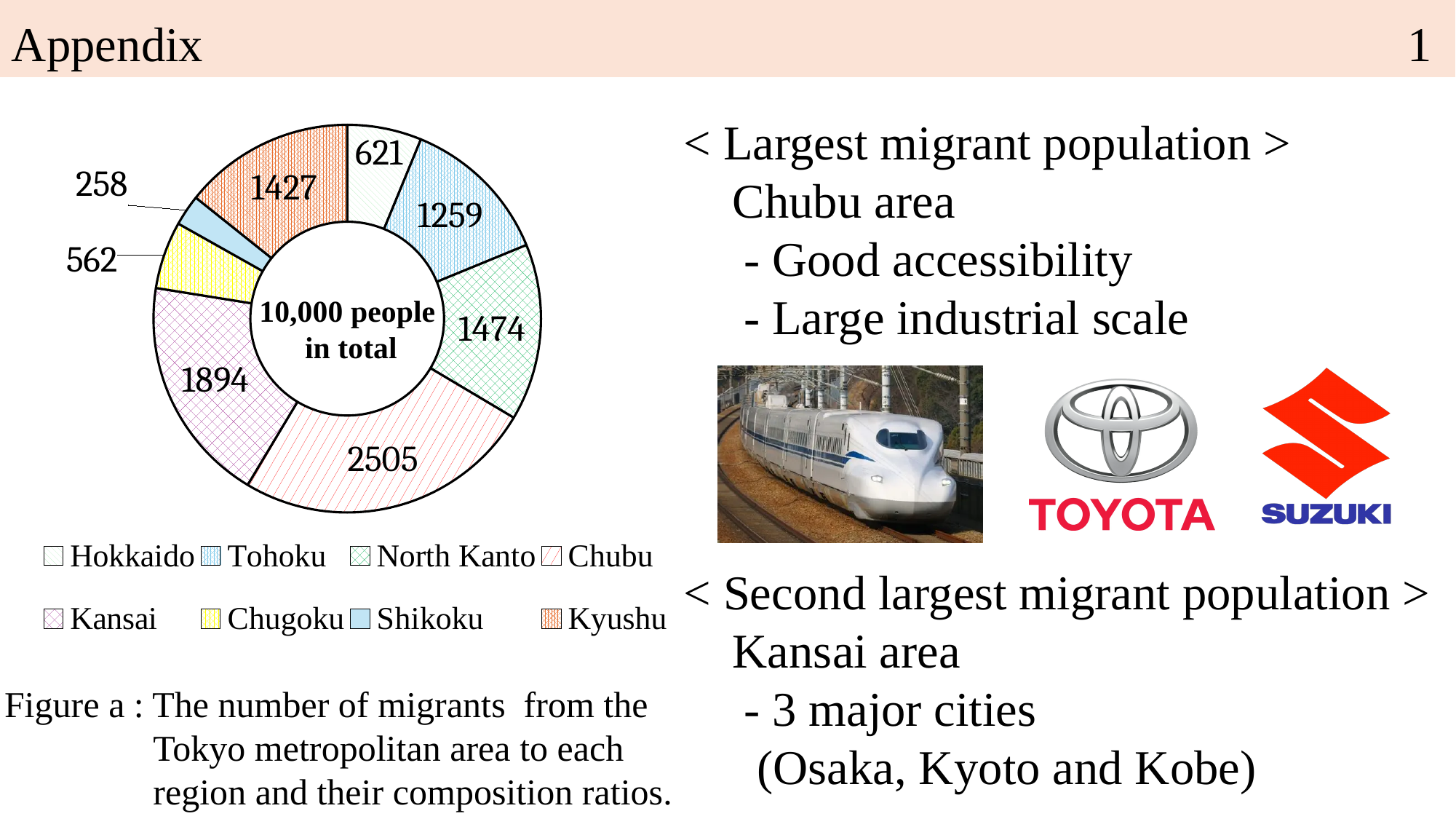
What share of the total does Chubu account for? 25.05% Which region has the smallest slice in the chart? Shikoku Which is larger, the value for North Kanto or the value for Kyushu? North Kanto Which region has the largest slice in the chart? Chubu What value does the chart show for Kansai? 1894 What is the difference between the values for Chubu and Kansai? 611 What kind of chart is shown on the slide? doughnut chart What value is shown for Shikoku in the chart? 258 What is the number of migrants to the Chubu region shown in the chart? 2505 What value does the chart show for Tohoku? 1259 What is the total number of people represented in the chart, as stated in its centre? 10,000 people How many regions are shown in the chart? 8